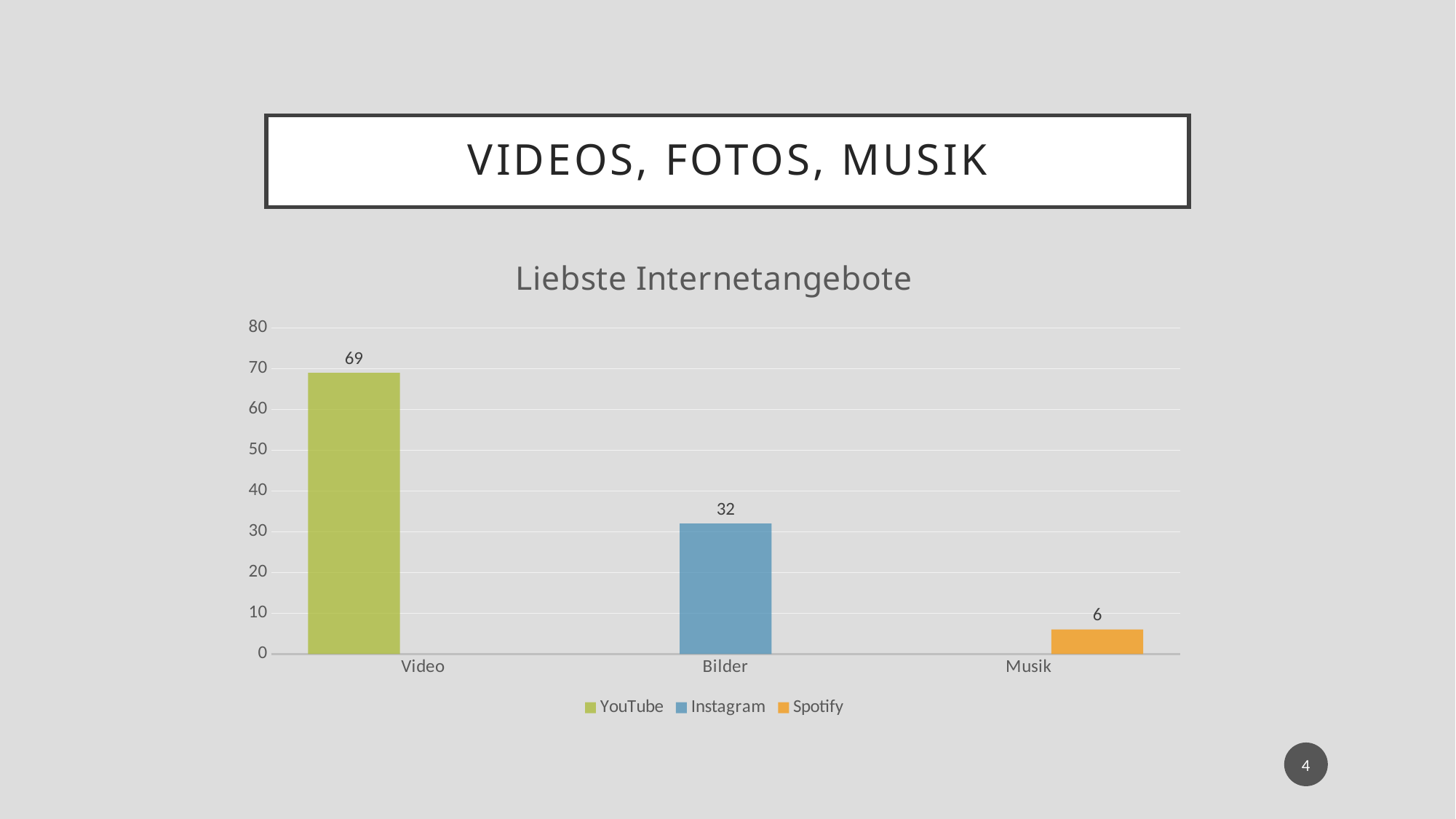
What is the value for Musik (Spotify) in the chart? 6 What kind of chart is shown on the slide? Bar chart What is the difference between the values for Bilder and Musik? 26 What is the difference between the values for Video and Bilder? 37 Which category has the lowest value? Musik What is the value for Video (YouTube) in the chart? 69 How many categories are shown on the x axis? 3 What is the title of the chart? Liebste Internetangebote Which category has the highest value? Video How many series does the legend list? 3 What is the value for Bilder (Instagram) in the chart? 32 Which is larger, the value for Bilder or the value for Musik? Bilder